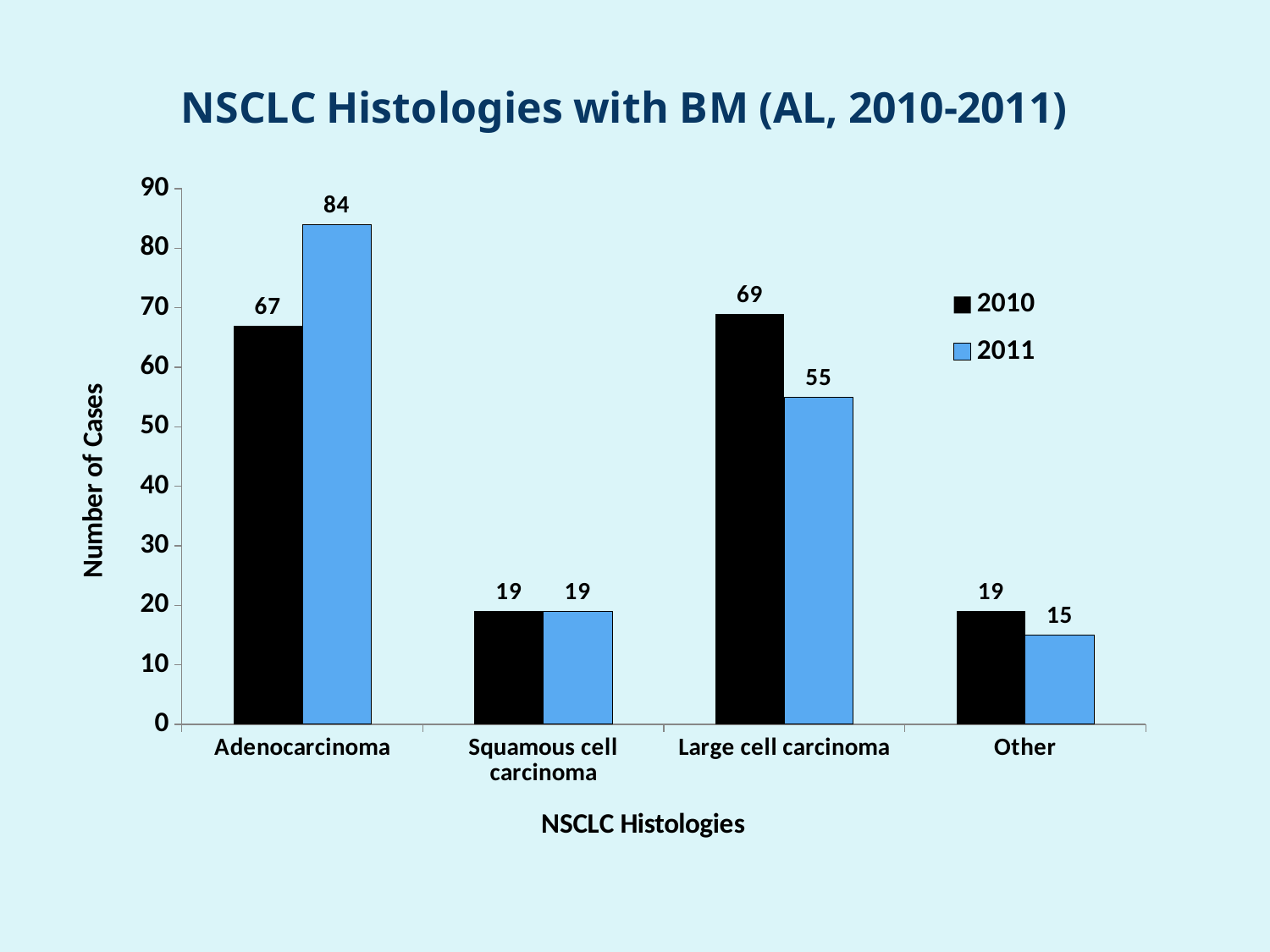
What is the number of cases for Adenocarcinoma in 2011? 84 What is the number of cases for Large cell carcinoma in 2010? 69 What is the title of the chart? NSCLC Histologies with BM (AL, 2010-2011) How many histology categories are shown on the x axis? 4 What is the difference between the 2011 and 2010 values for Adenocarcinoma? 17 How many series does the legend list? 2 What is the difference between the 2010 and 2011 values for Large cell carcinoma? 14 What kind of chart is shown on the slide? Bar chart Which is larger for Large cell carcinoma: the 2010 value or the 2011 value? 2010 Which histology has the highest number of cases in 2011? Adenocarcinoma Which histology has the lowest number of cases in 2011? Other What is the number of cases for Other in 2011? 15